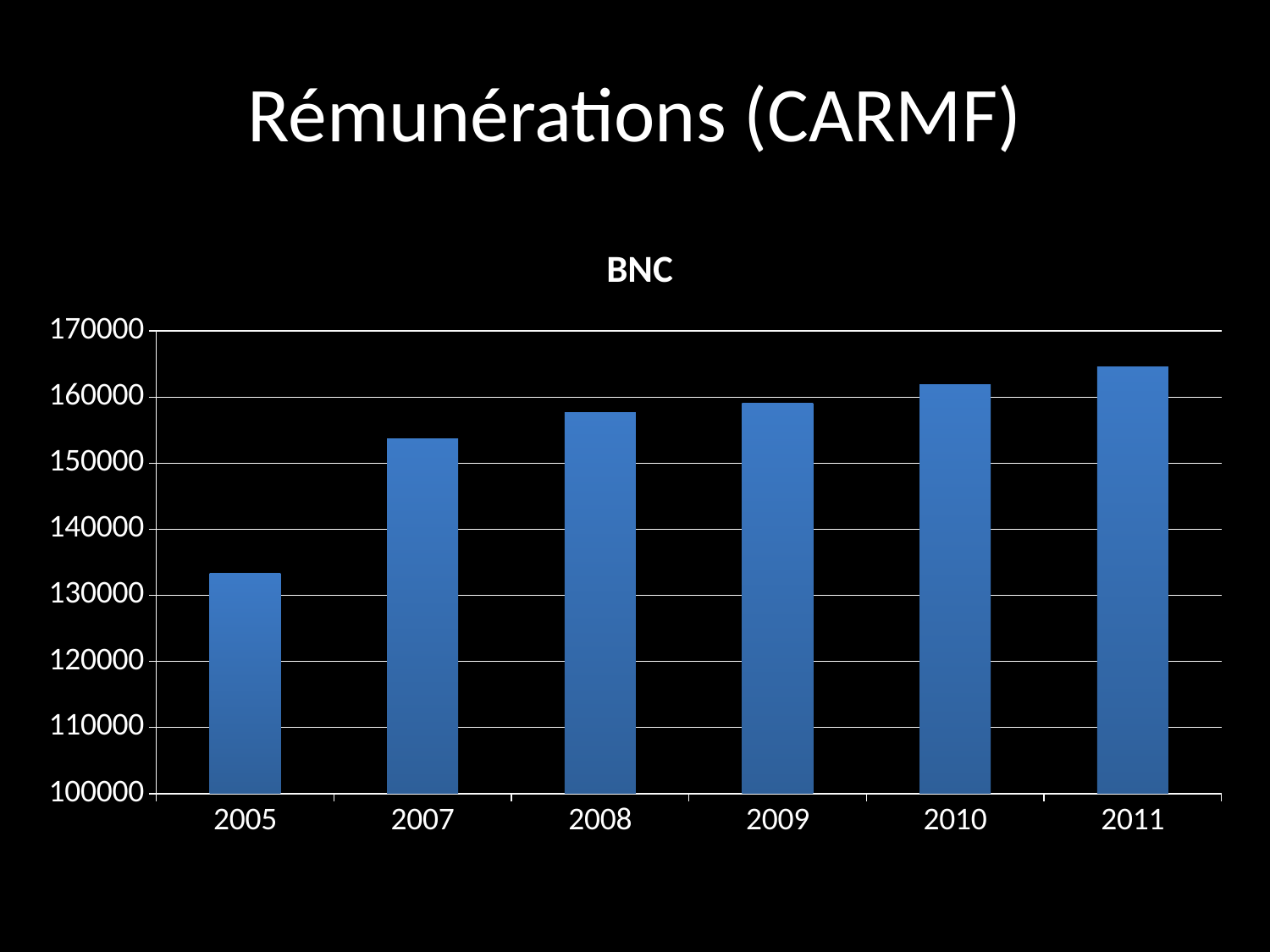
Is the value for 2011 greater or less than 160000? greater Do the BNC values rise or fall from 2005 to 2011? rise What type of chart is shown on the slide? bar chart Which is larger, the value for 2005 or the value for 2009? 2009 Which year has the highest BNC value? 2011 Which year has the lowest BNC value? 2005 Is the value for 2008 greater or less than 160000? less Which is larger, the value for 2007 or the value for 2010? 2010 What is the title of the chart? BNC How many years are shown on the x axis of the chart? 6 Is the value for 2005 greater or less than 140000? less